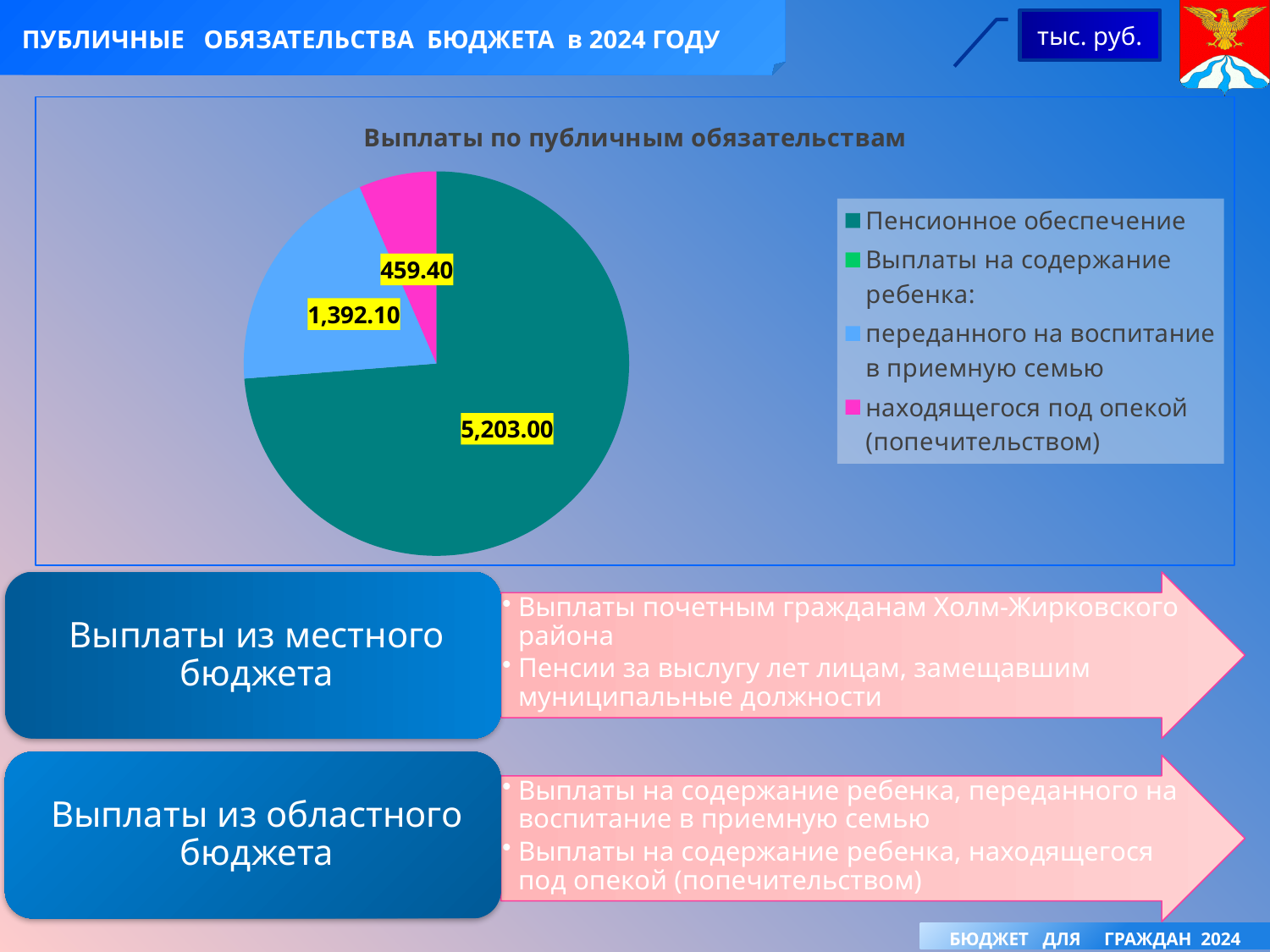
Which category has the largest slice of the pie? Пенсионное обеспечение What is the value for the child maintenance payments for a child under guardianship (находящегося под опекой (попечительством))? 459.40 What is the value for Пенсионное обеспечение? 5,203.00 Which category has the smallest slice of the pie? находящегося под опекой (попечительством) What is the difference between the value for Пенсионное обеспечение and the value for переданного на воспитание в приемную семью? 3,810.90 What is the title of the chart? Выплаты по публичным обязательствам What type of chart is shown on the slide? pie chart Which is larger: the value for переданного на воспитание в приемную семью or the value for находящегося под опекой (попечительством)? переданного на воспитание в приемную семью How many slices does the pie chart have? 3 What is the difference between the value for переданного на воспитание в приемную семью and the value for находящегося под опекой (попечительством)? 932.70 What is the value for the child maintenance payments for a child placed in a foster family (переданного на воспитание в приемную семью)? 1,392.10 What colour is the slice for Пенсионное обеспечение? dark teal (green)